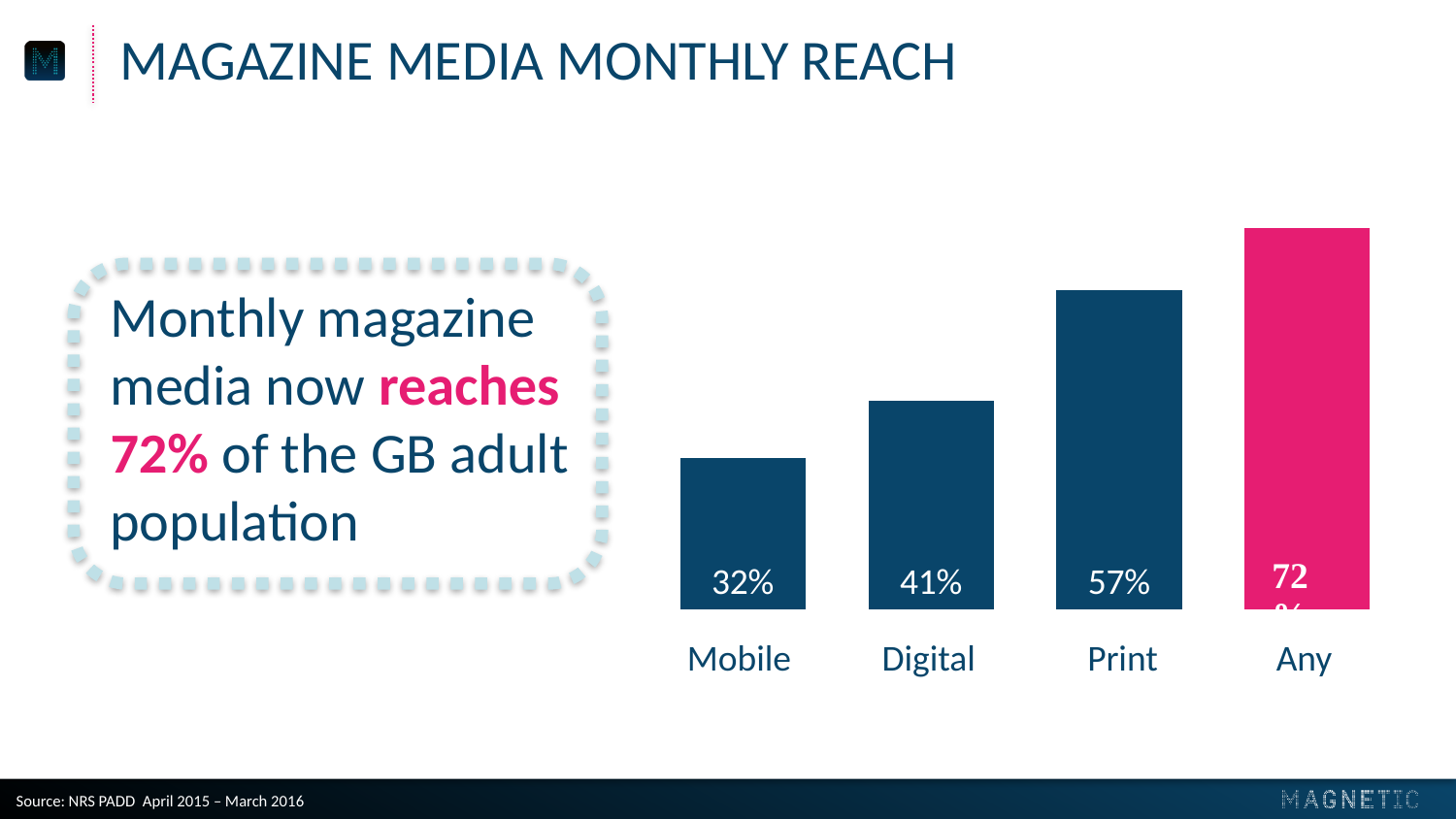
What is the monthly reach value for Any? 72% Do the values rise or fall from Mobile to Any along the x axis? Rise What is the difference between the Print and Mobile reach values? 25% What kind of chart is shown on the slide? Bar chart Which is larger, the reach for Digital or the reach for Print? Print How many categories are shown in the chart? 4 What is the monthly reach value for Digital? 41% Which category has the lowest monthly reach? Mobile What is the difference between the Any and Print reach values? 15% What is the monthly reach value for Mobile? 32% What is the monthly reach value for Print? 57% Which category has the highest monthly reach? Any